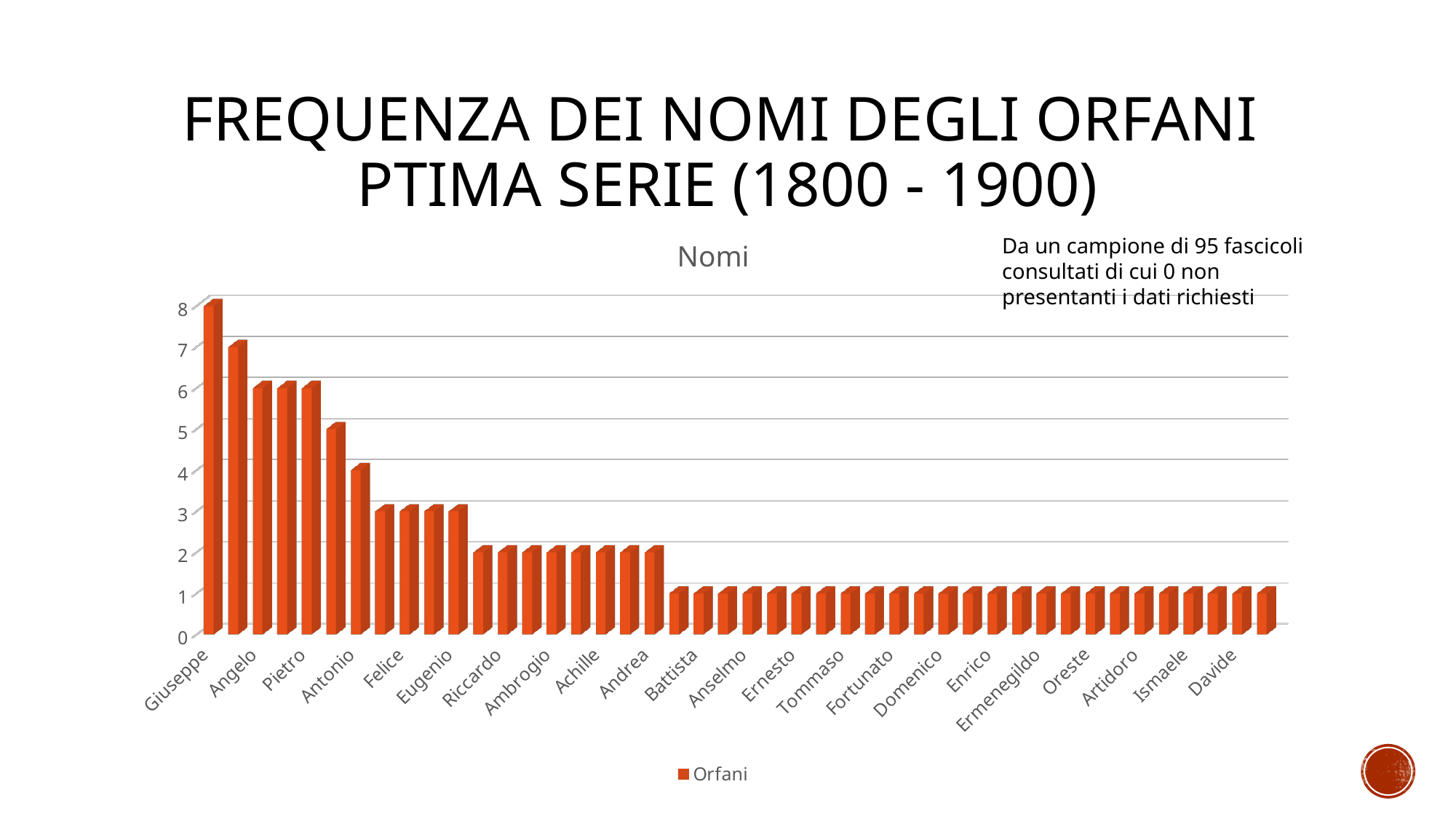
What is the title of the chart? Nomi What is the value for Giuseppe? 8 What is the value for Tommaso? 1 Which name has the highest frequency in the chart? Giuseppe What is the name of the series shown in the legend? Orfani Do the values rise or fall from left to right along the x axis? fall What type of chart is shown on the slide? bar chart Which is larger, the value for Giuseppe or the value for Ernesto? Giuseppe Is the value for Oreste greater or less than 2? less What is the value for Davide? 1 Is the value for Giuseppe greater or less than 5? greater How many series does the chart legend list? 1